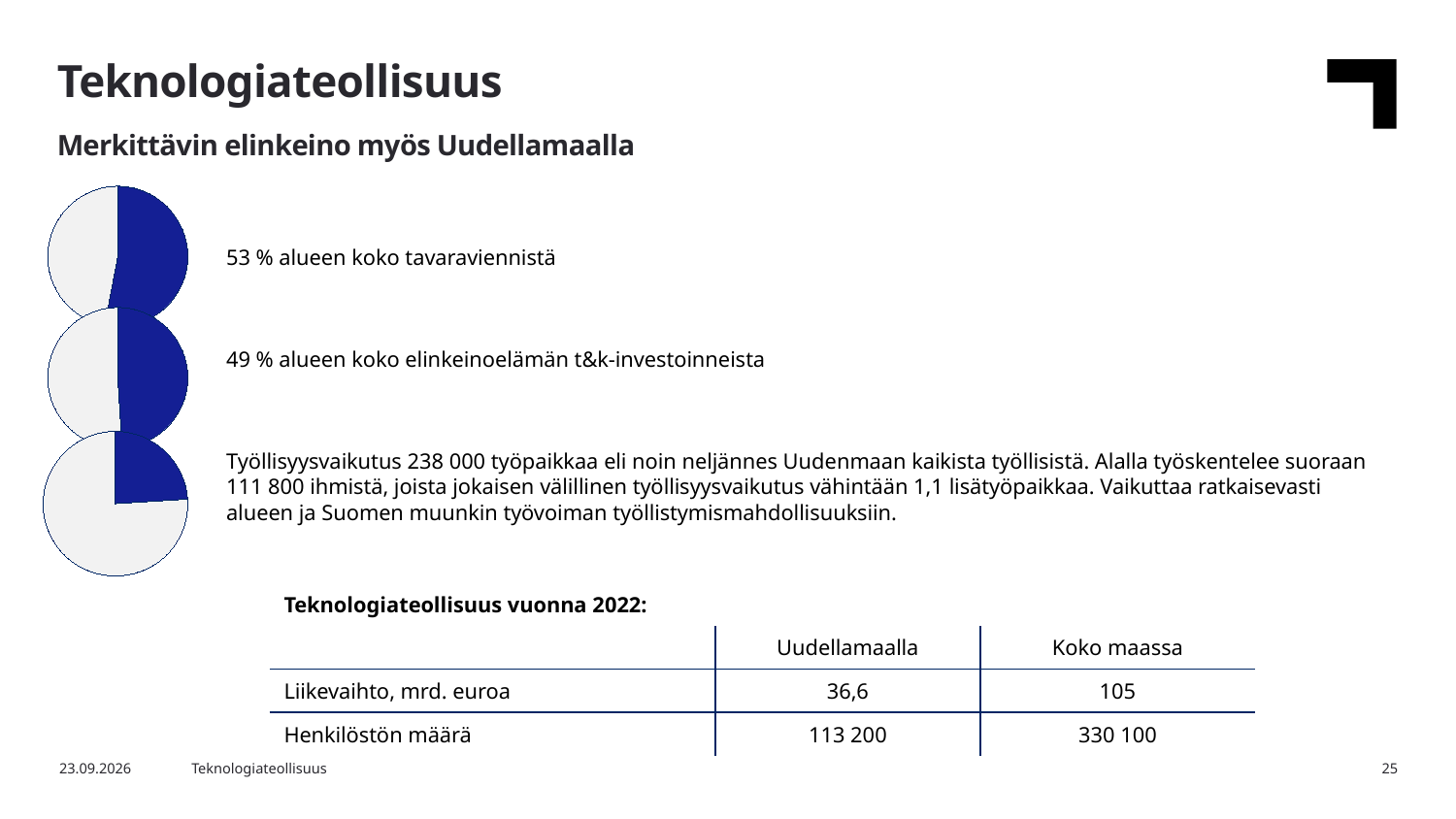
According to the text next to the top pie chart, what share of the region's total goods exports does the blue slice represent? 53 % Which pie chart has the smallest blue slice: the top, middle or bottom one? Bottom What kind of chart is used for the three small graphics on the left of the slide? Pie chart According to the text next to the middle pie chart, what share of the region's business R&D investments does the blue slice represent? 49 % How many pie charts are shown on the slide? 3 In the top pie chart, is the blue slice greater or less than 50% of the pie? greater What text accompanies the middle pie chart? 49 % alueen koko elinkeinoelämän t&k-investoinneista Is the blue slice larger in the top pie chart or in the bottom pie chart? Top pie chart Which pie chart has the largest blue slice: the top, middle or bottom one? Top In the bottom pie chart, is the blue slice greater or less than 50% of the pie? less What is the difference between the share shown for the top pie chart (53 %) and the share shown for the middle pie chart (49 %)? 4 percentage points What two colours are used for the slices in the pie charts? Blue and light grey